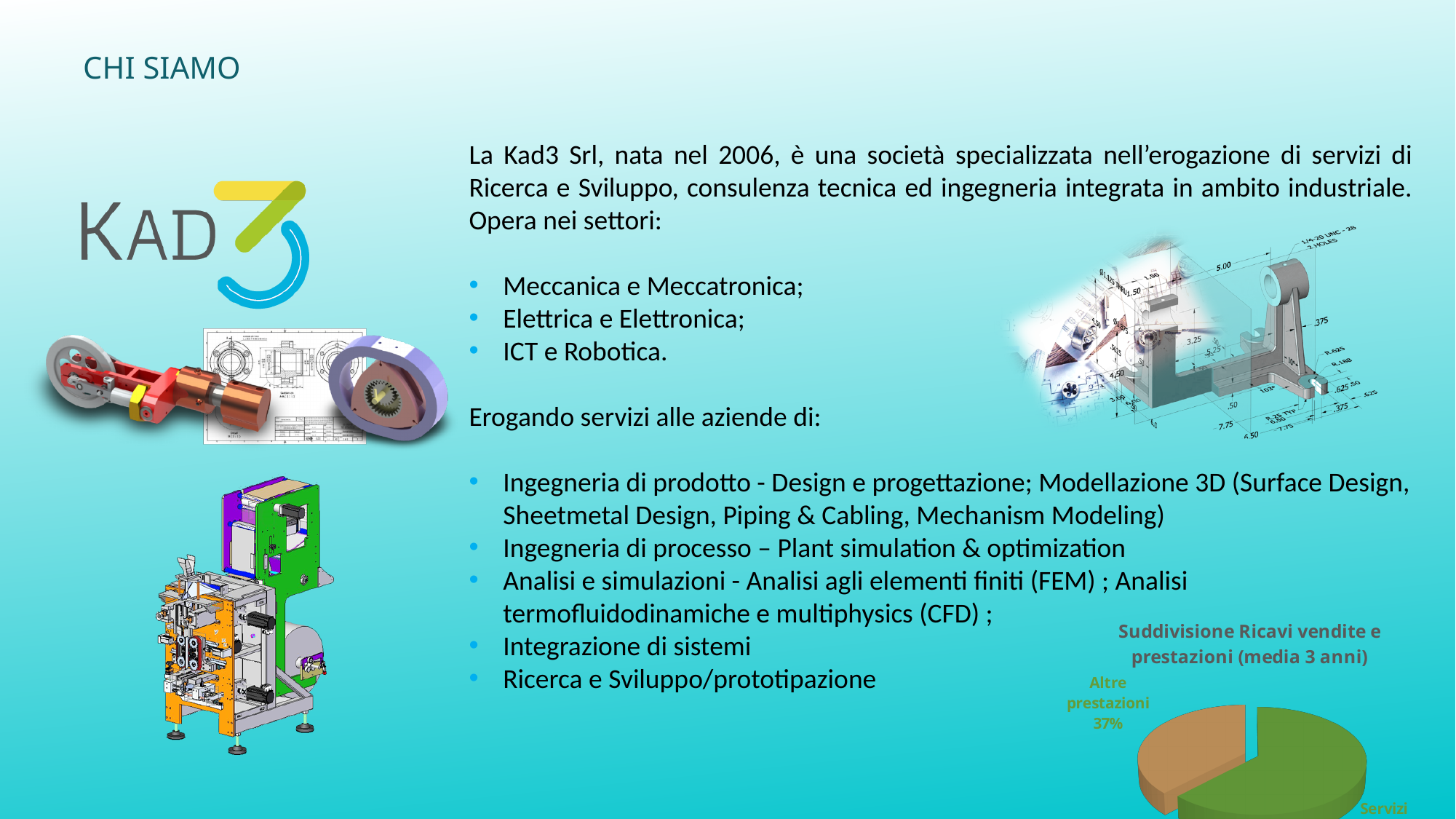
How many slices does the pie chart have? 2 Which slice of the pie chart is the smallest? Altre prestazioni Does the Altre prestazioni slice represent more or less than half of the pie chart? Less Which slice of the pie chart is the largest? Servizi What is the title of the pie chart on the slide? Suddivisione Ricavi vendite e prestazioni (media 3 anni) What colour is the Servizi slice in the pie chart? Green What kind of chart is shown at the bottom right of the slide? Pie chart In the pie chart, what percentage is shown for Altre prestazioni? 37% Which slice of the pie chart is larger, Servizi or Altre prestazioni? Servizi